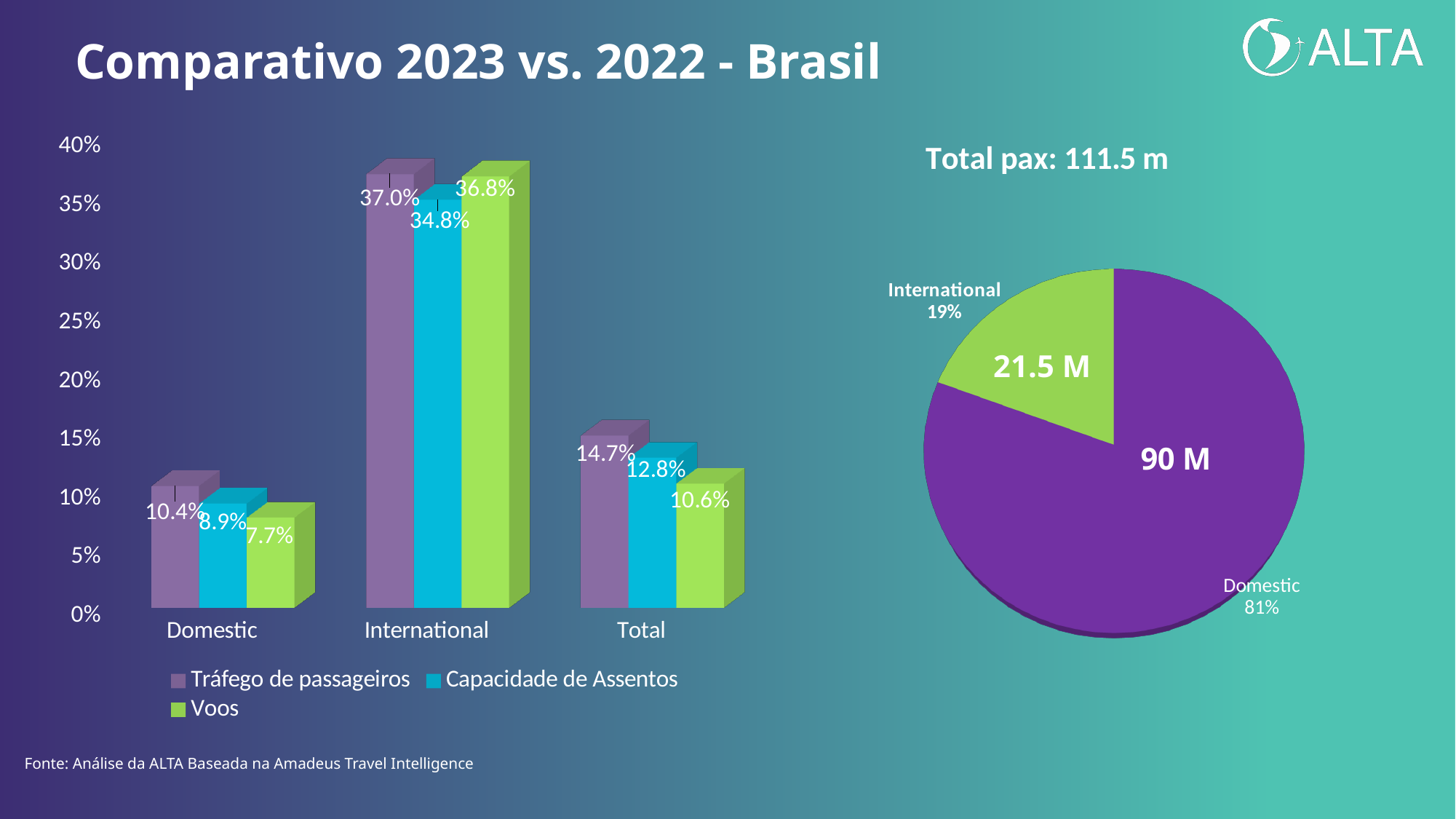
What kind of chart is the chart on the right titled 'Total pax: 111.5 m'? Pie chart In the bar chart on the left, what is the difference between Tráfego de passageiros and Capacidade de Assentos for Total? 1.9% How many series does the legend of the bar chart on the left list? 3 In the pie chart titled 'Total pax: 111.5 m', what share does International have? 19% In the bar chart on the left, what is the value of Voos for Total? 10.6% In the bar chart on the left, what is the value of Capacidade de Assentos for Domestic? 8.9% In the bar chart on the left, which category has the highest value for Tráfego de passageiros? International In the bar chart on the left, which category has the lowest value for Voos? Domestic In the bar chart on the left, which is larger for International: Capacidade de Assentos or Voos? Voos How many categories are shown on the x axis of the bar chart on the left? 3 In the pie chart titled 'Total pax: 111.5 m', what is the value shown for Domestic? 90 M In the bar chart on the left, what is the value of Tráfego de passageiros for International? 37.0%